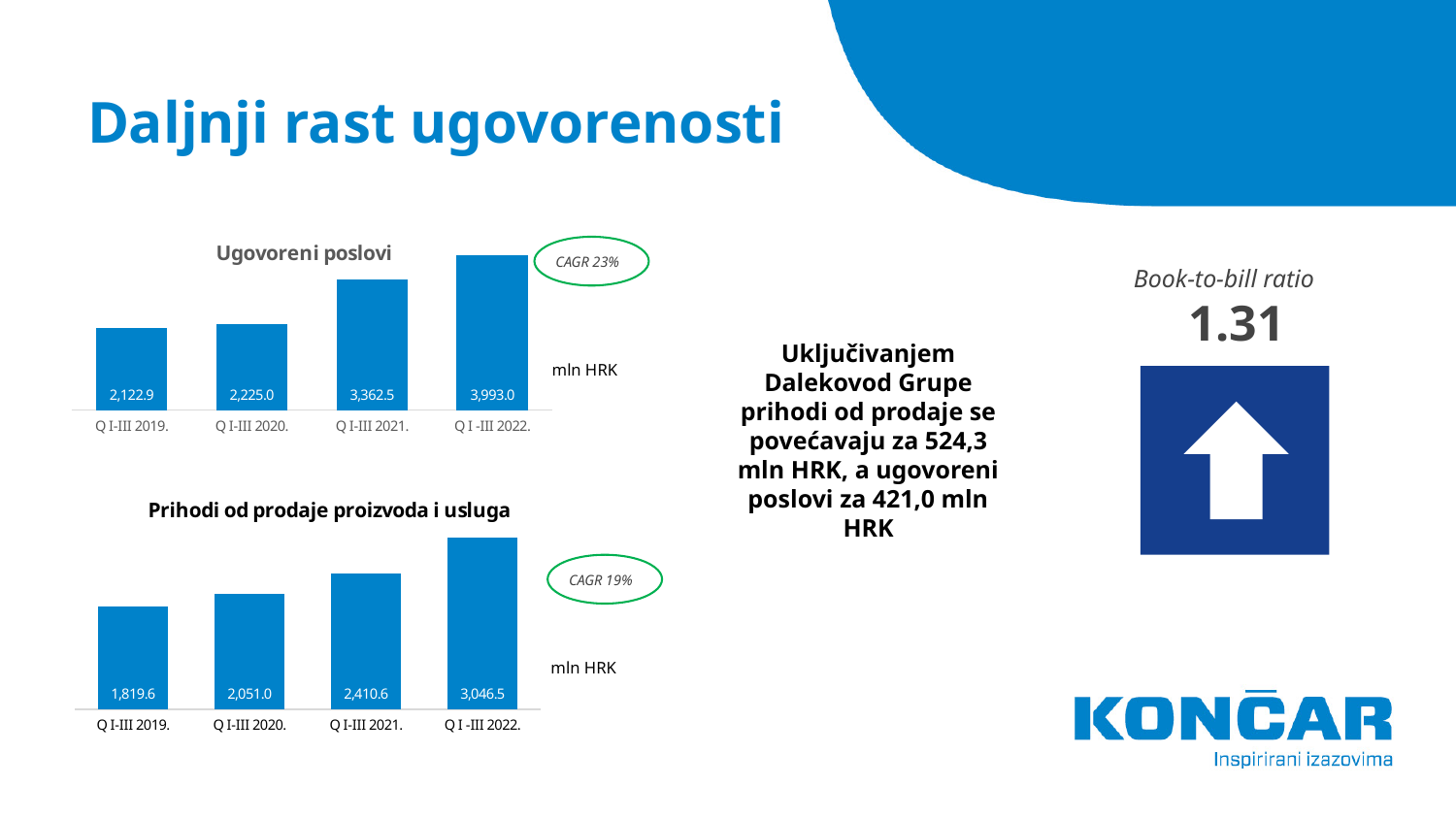
In the 'Ugovoreni poslovi' chart, what is the value for Q I-III 2021.? 3,362.5 In the 'Ugovoreni poslovi' chart, which period has the highest value? Q I -III 2022. In the 'Ugovoreni poslovi' chart, what is the difference between the values for Q I -III 2022. and Q I-III 2019.? 1,870.1 In the 'Ugovoreni poslovi' chart, which period has the lowest value? Q I-III 2019. In the 'Prihodi od prodaje proizvoda i usluga' chart, what is the difference between the values for Q I-III 2021. and Q I-III 2020.? 359.6 What CAGR is shown next to the 'Prihodi od prodaje proizvoda i usluga' chart? CAGR 19% What kind of chart is the 'Ugovoreni poslovi' chart? bar chart In the 'Prihodi od prodaje proizvoda i usluga' chart, which period has the lowest value? Q I-III 2019. In the 'Prihodi od prodaje proizvoda i usluga' chart, what is the value for Q I -III 2022.? 3,046.5 In the 'Ugovoreni poslovi' chart, how many periods are shown? 4 In the 'Prihodi od prodaje proizvoda i usluga' chart, what is the value for Q I-III 2020.? 2,051.0 In the 'Prihodi od prodaje proizvoda i usluga' chart, do the values rise or fall from Q I-III 2019. to Q I -III 2022.? rise